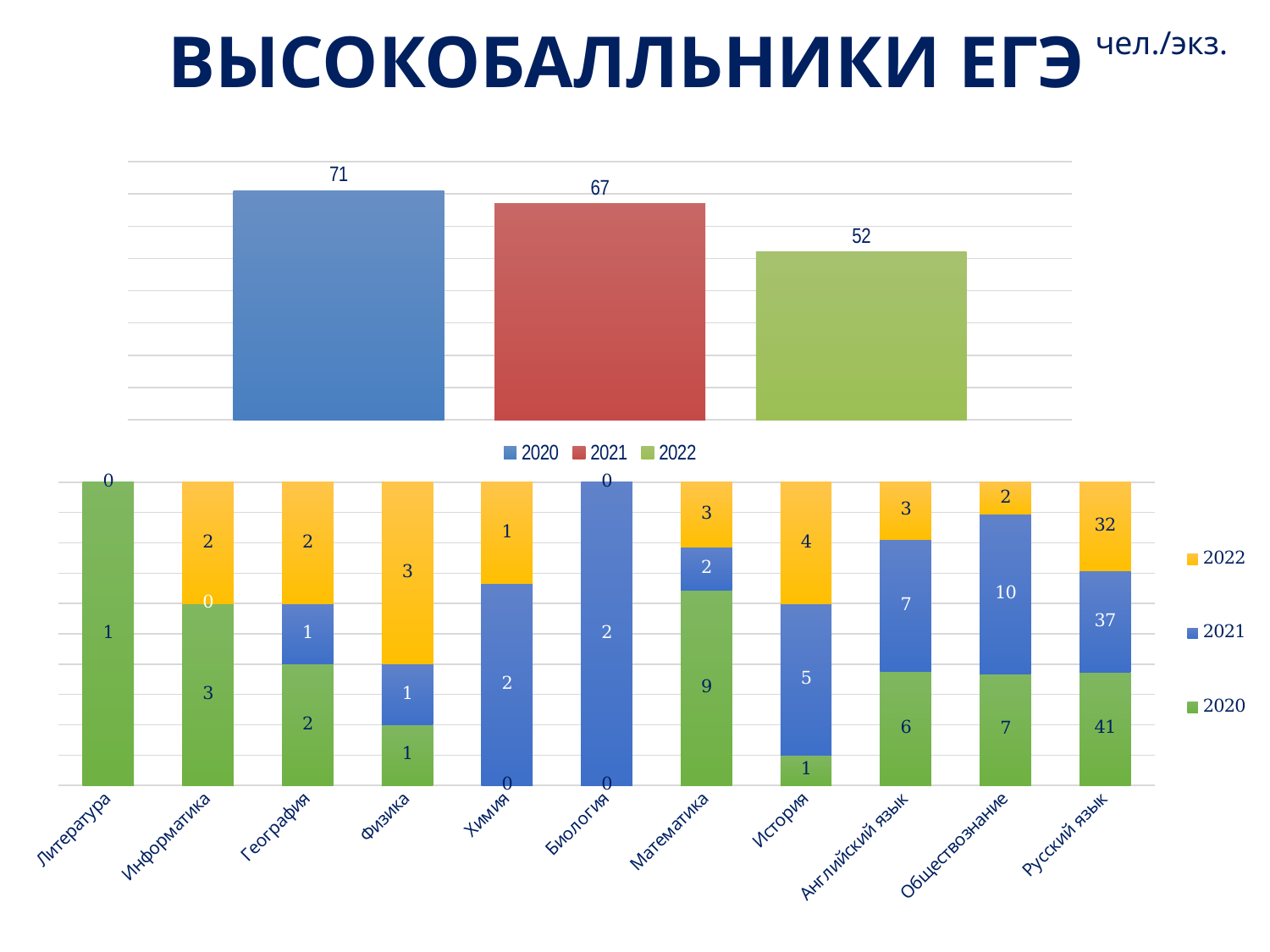
In the top chart, how many bars are plotted? 3 In the top chart, what is the value for 2020? 71 In the top chart, do the values rise or fall from 2020 to 2022? fall In the bottom chart, how many subjects are shown on the x axis? 11 How many series does the legend of the bottom chart list? 3 In the top chart, what is the difference between the 2020 and 2022 values? 19 In the top chart, which year has the lowest value? 2022 In the bottom chart, what is the total of the stacked bar for Русский язык? 110 In the bottom chart, what is the 2020 value for Математика? 9 In the bottom chart, which is larger: the 2021 value for История or the 2021 value for Английский язык? Английский язык In the bottom chart, what is the 2021 value for Обществознание? 10 What kind of chart is the bottom chart? stacked bar chart